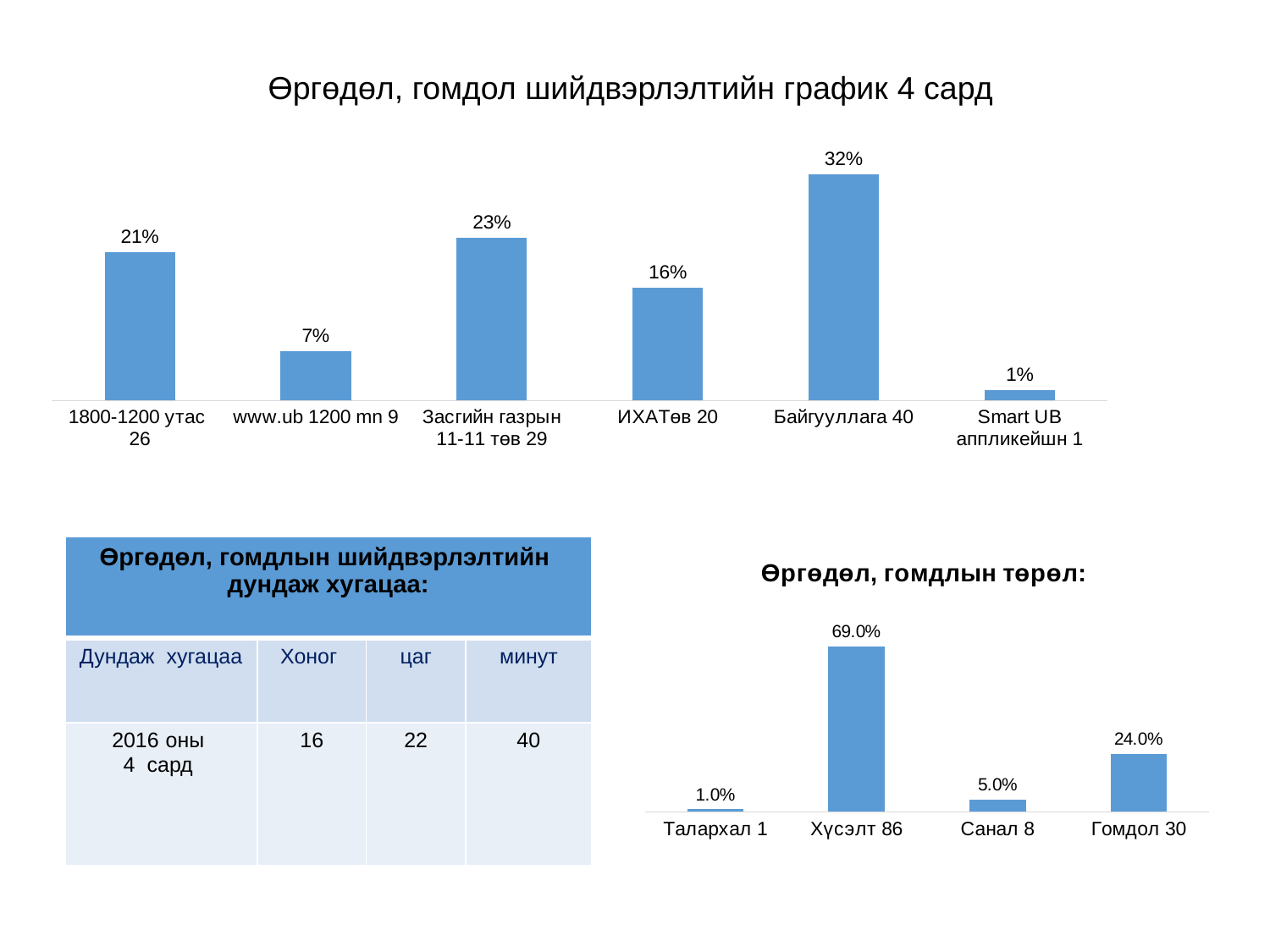
In the top chart 'Өргөдөл, гомдол шийдвэрлэлтийн график 4 сард', which category has the lowest value? Smart UB аппликейшн 1 How many categories are shown in the top chart 'Өргөдөл, гомдол шийдвэрлэлтийн график 4 сард'? 6 In the top chart 'Өргөдөл, гомдол шийдвэрлэлтийн график 4 сард', what is the difference between 'Засгийн газрын 11-11 төв 29' and 'ИХАТөв 20'? 7% In the top chart 'Өргөдөл, гомдол шийдвэрлэлтийн график 4 сард', which category has the highest value? Байгууллага 40 In the bottom-right chart 'Өргөдөл, гомдлын төрөл:', which category has the lowest value? Талархал 1 In the top chart 'Өргөдөл, гомдол шийдвэрлэлтийн график 4 сард', which is larger: '1800-1200 утас 26' or 'Засгийн газрын 11-11 төв 29'? Засгийн газрын 11-11 төв 29 In the bottom-right chart 'Өргөдөл, гомдлын төрөл:', what is the difference between 'Гомдол 30' and 'Санал 8'? 19.0% What type of chart is the top chart 'Өргөдөл, гомдол шийдвэрлэлтийн график 4 сард'? Bar chart In the top chart 'Өргөдөл, гомдол шийдвэрлэлтийн график 4 сард', what is the value for 'Байгууллага 40'? 32% How many categories are shown in the bottom-right chart 'Өргөдөл, гомдлын төрөл:'? 4 In the bottom-right chart 'Өргөдөл, гомдлын төрөл:', what is the value for 'Хүсэлт 86'? 69.0% In the top chart 'Өргөдөл, гомдол шийдвэрлэлтийн график 4 сард', what is the value for 'www.ub 1200 mn 9'? 7%